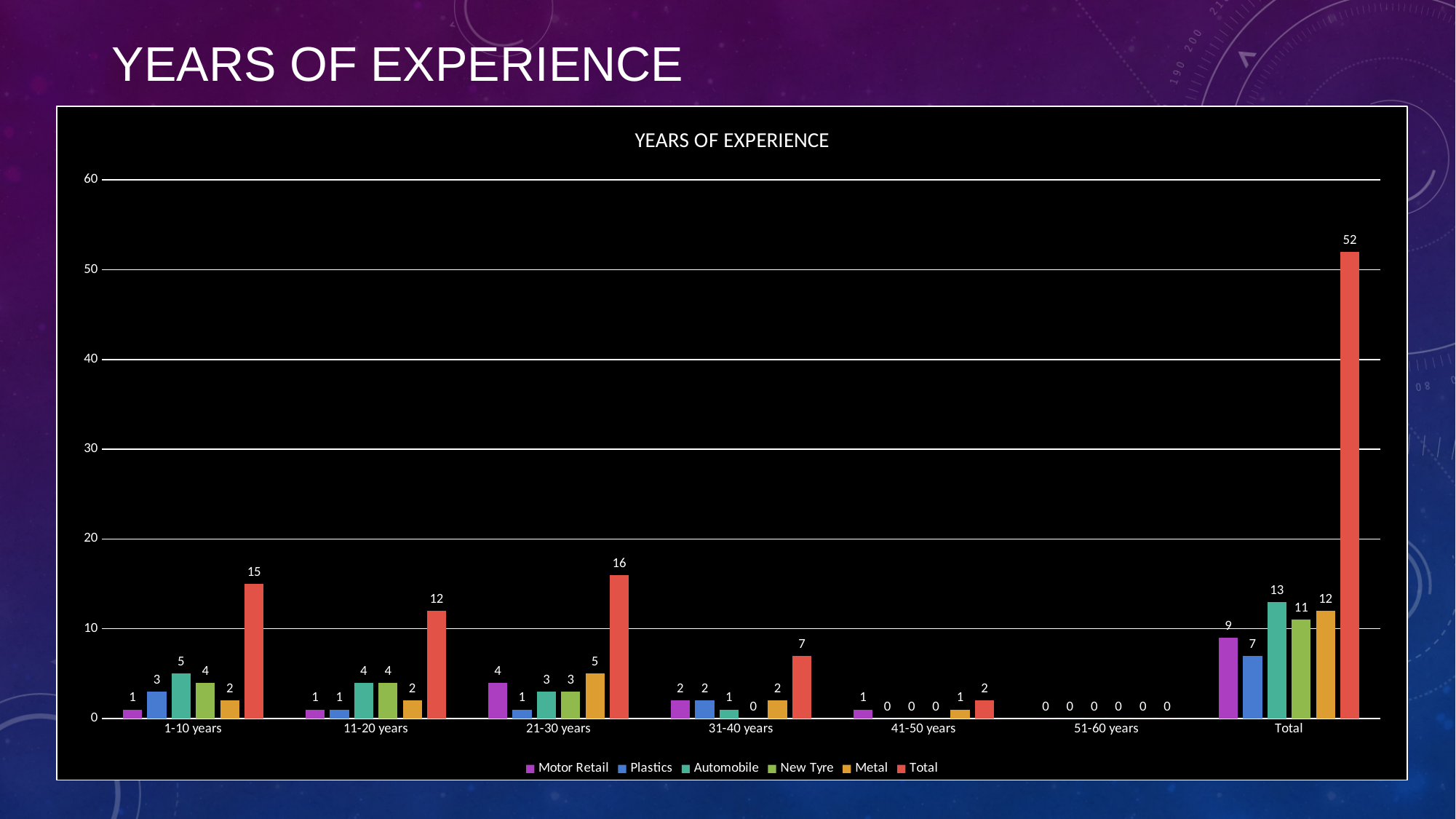
What is the value for Automobile in the 1-10 years category? 5 Among the year-range categories (excluding Total), which has the lowest Total value? 51-60 years Which is larger in the Total category: Automobile or New Tyre? Automobile How many categories are shown on the x axis? 7 What is the value for Metal in the Total category? 12 What kind of chart is shown on the slide? Bar chart How many series does the legend list? 6 What is the difference between the Total values for 21-30 years and 11-20 years? 4 What is the Total value for the 21-30 years category? 16 Is the Total value for the Total category greater or less than 50? greater What is the title of the chart? YEARS OF EXPERIENCE Which category has the highest Total value? Total